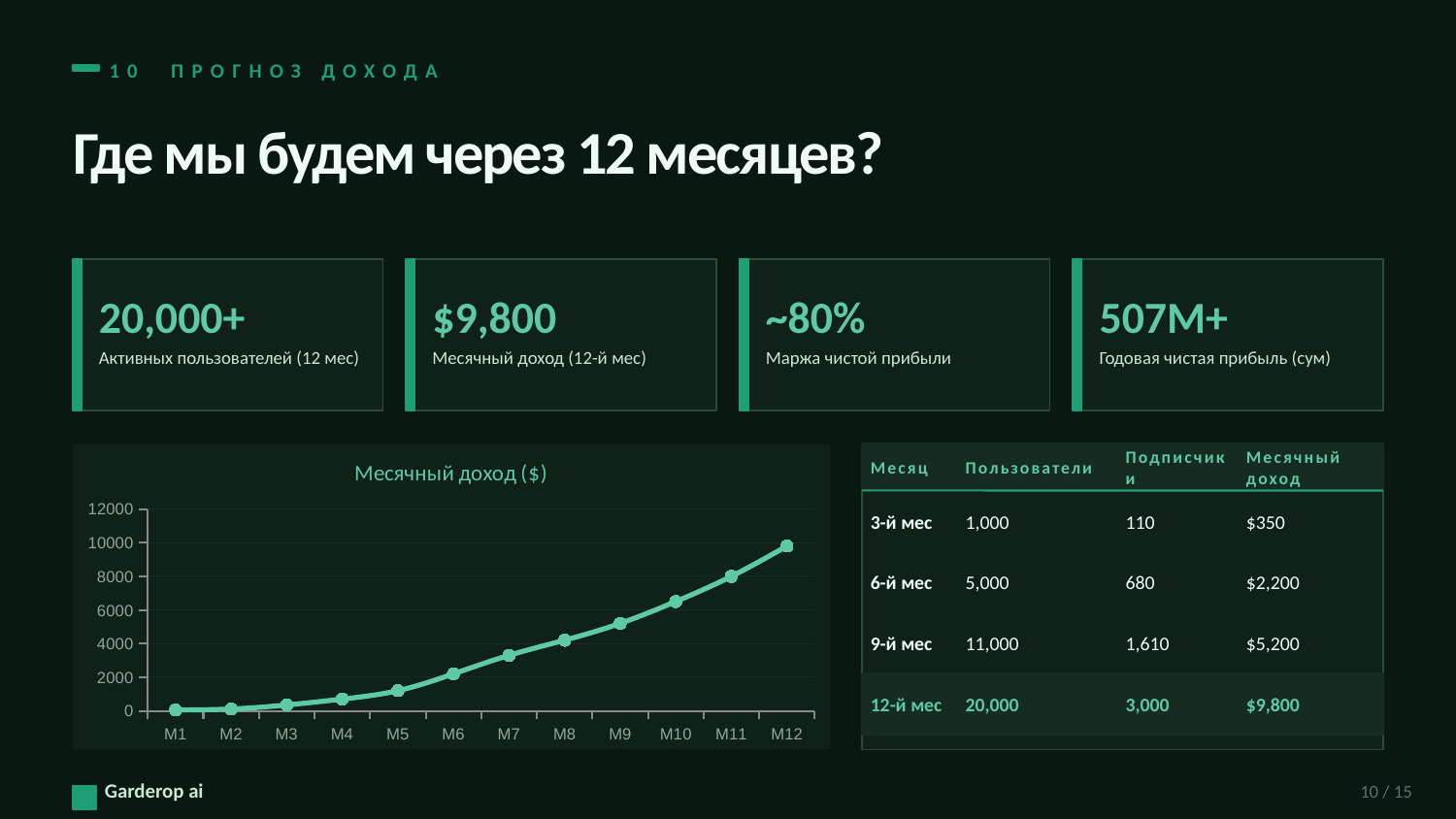
What kind of chart is shown on the slide? line chart Do the values in the chart rise or fall from M1 to M12? rise Is the value for M10 in the chart greater or less than 6000? greater How many months (data points) are plotted on the x axis of the chart? 12 Which is larger in the chart, the value for M10 or the value for M5? M10 Which month has the highest value in the chart? M12 According to the slide, what is the monthly income for the 12th month (M12)? $9,800 Is the value for M4 in the chart greater or less than 2000? less Which month has the lowest value in the chart? M1 According to the slide, what is the monthly income for the 9th month (M9)? $5,200 What is the title of the chart? Месячный доход ($)